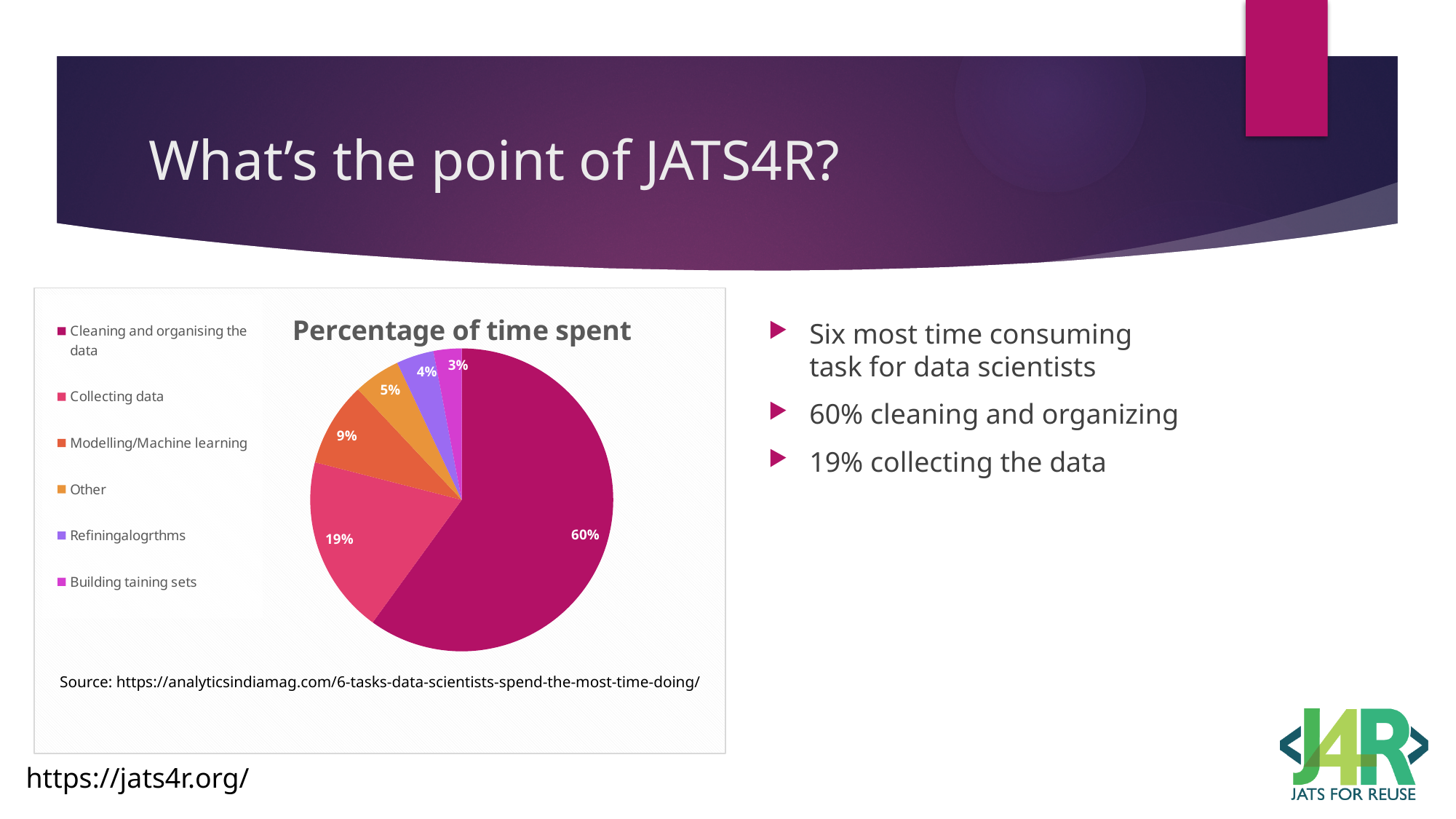
What kind of chart is shown on the slide? Pie chart What is the title of the chart? Percentage of time spent Which category takes the largest share of time? Cleaning and organising the data What percentage of time is spent on Modelling/Machine learning? 9% Which category takes the smallest share of time? Building taining sets What is the difference in percentage points between Cleaning and organising the data and Collecting data? 41 Which is larger, the share for Other or the share for Refiningalogrthms? Other What is the share of the pie for Refiningalogrthms? 4% How many categories does the pie chart show? 6 What percentage of time is spent on Cleaning and organising the data? 60% What percentage of time is spent on Building taining sets? 3% What percentage of time is spent on Collecting data? 19%